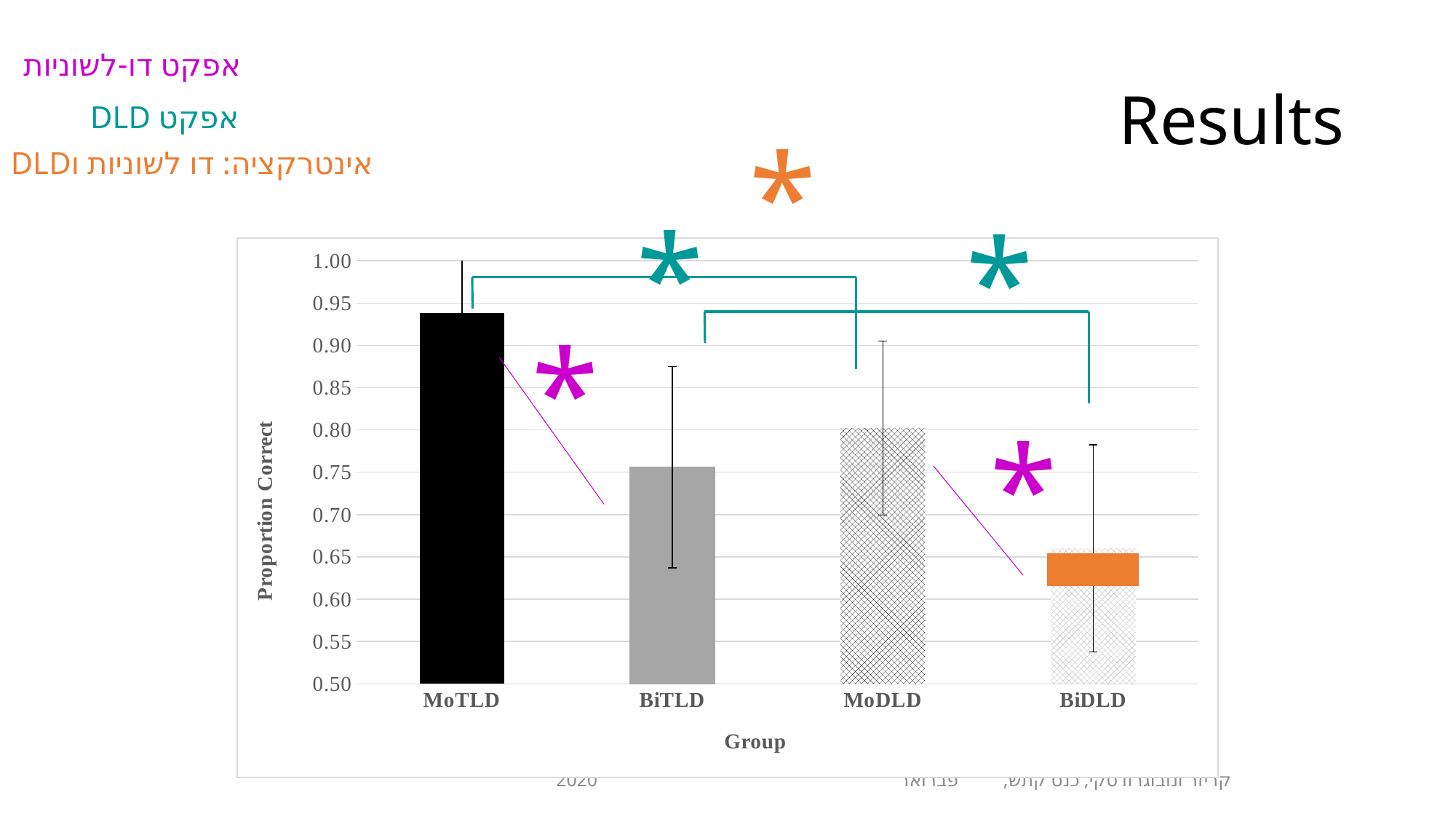
What is the title of the x axis of the chart? Group What kind of chart is shown on the slide? bar chart Which group has the lowest proportion correct? BiDLD Which group has a higher proportion correct, MoTLD or MoDLD? MoTLD How many groups are shown on the x axis of the chart? 4 Is the value for BiDLD greater or less than 0.70? less Which group has a higher proportion correct, MoDLD or BiDLD? MoDLD What is the title of the y axis of the chart? Proportion Correct Which group has a higher proportion correct, MoTLD or BiTLD? MoTLD Is the value for MoTLD greater or less than 0.90? greater Is the value for BiTLD greater or less than 0.80? less Which group has the highest proportion correct? MoTLD